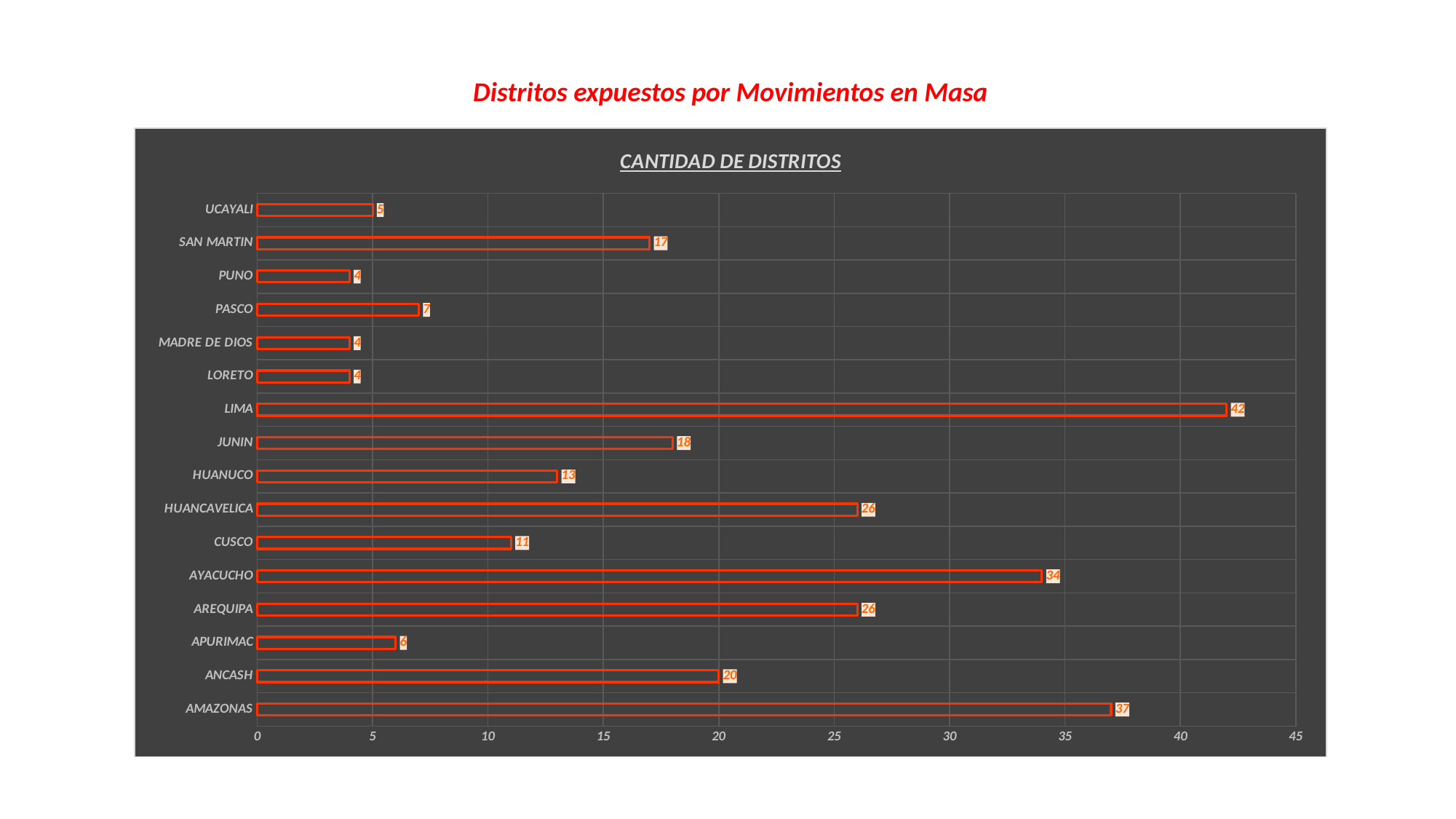
What is the difference between the values for AMAZONAS and AYACUCHO? 3 Which is larger, the value for JUNIN or the value for HUANUCO? JUNIN What is the value for SAN MARTIN? 17 What is the title of the chart? CANTIDAD DE DISTRITOS How many categories are shown on the chart? 16 What is the difference between the values for LIMA and UCAYALI? 37 What is the value for APURIMAC? 6 What kind of chart is shown? bar chart Is the value for ANCASH greater or less than 15? greater Which category has the highest value? LIMA What is the value for HUANCAVELICA? 26 What is the value for LIMA? 42